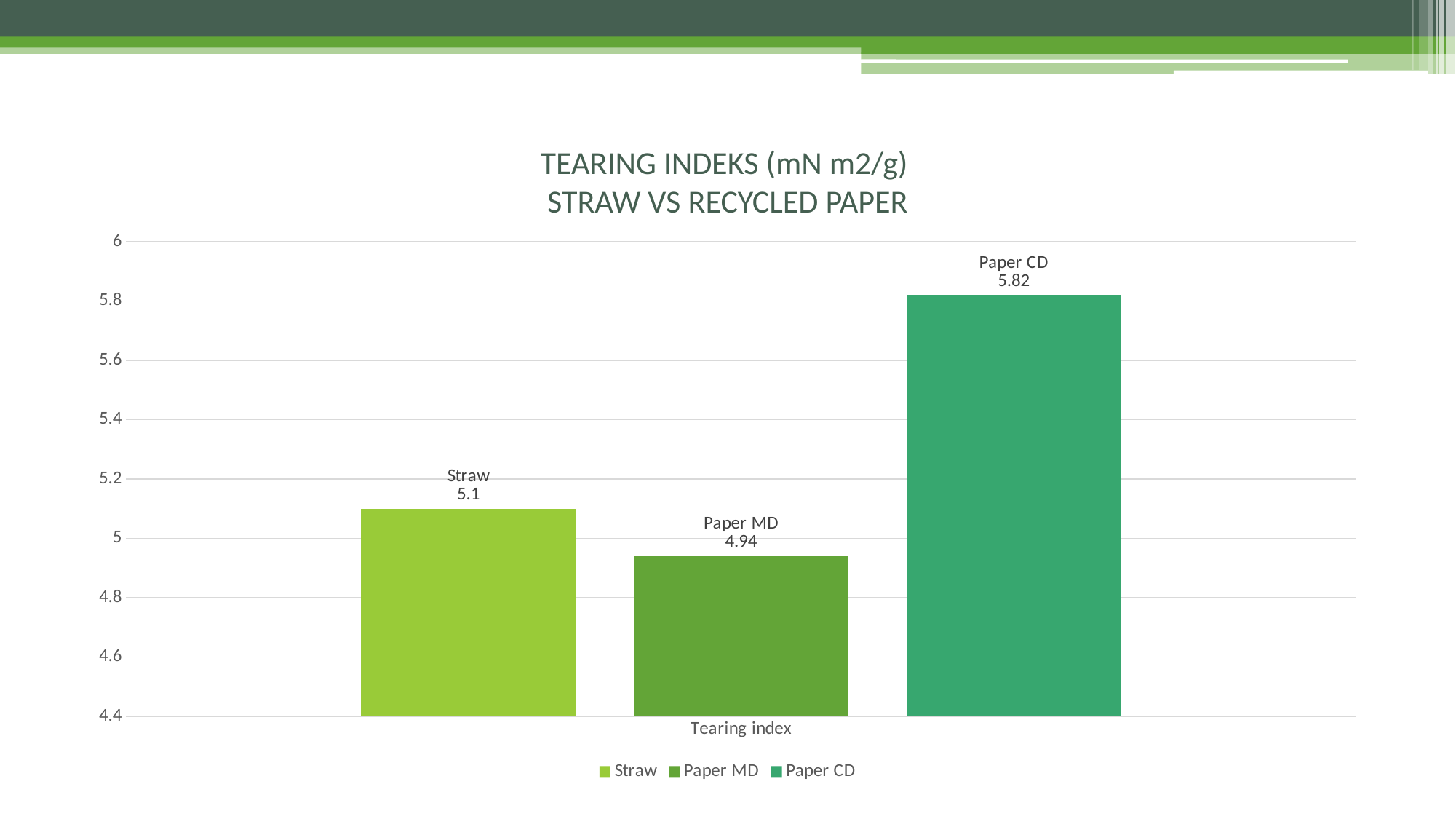
Is the value for Paper CD greater or less than 5.6? greater What kind of chart is shown on the slide? Bar chart Which has a larger tearing index, Straw or Paper MD? Straw What is the tearing index value for Straw? 5.1 Which series has the lowest tearing index? Paper MD Which series has the highest tearing index? Paper CD What is the title of the chart? TEARING INDEKS (mN m2/g) STRAW VS RECYCLED PAPER What is the difference between the tearing index of Paper CD and Straw? 0.72 What is the difference between the tearing index of Straw and Paper MD? 0.16 What is the tearing index value for Paper CD? 5.82 How many series does the legend list? 3 What is the tearing index value for Paper MD? 4.94